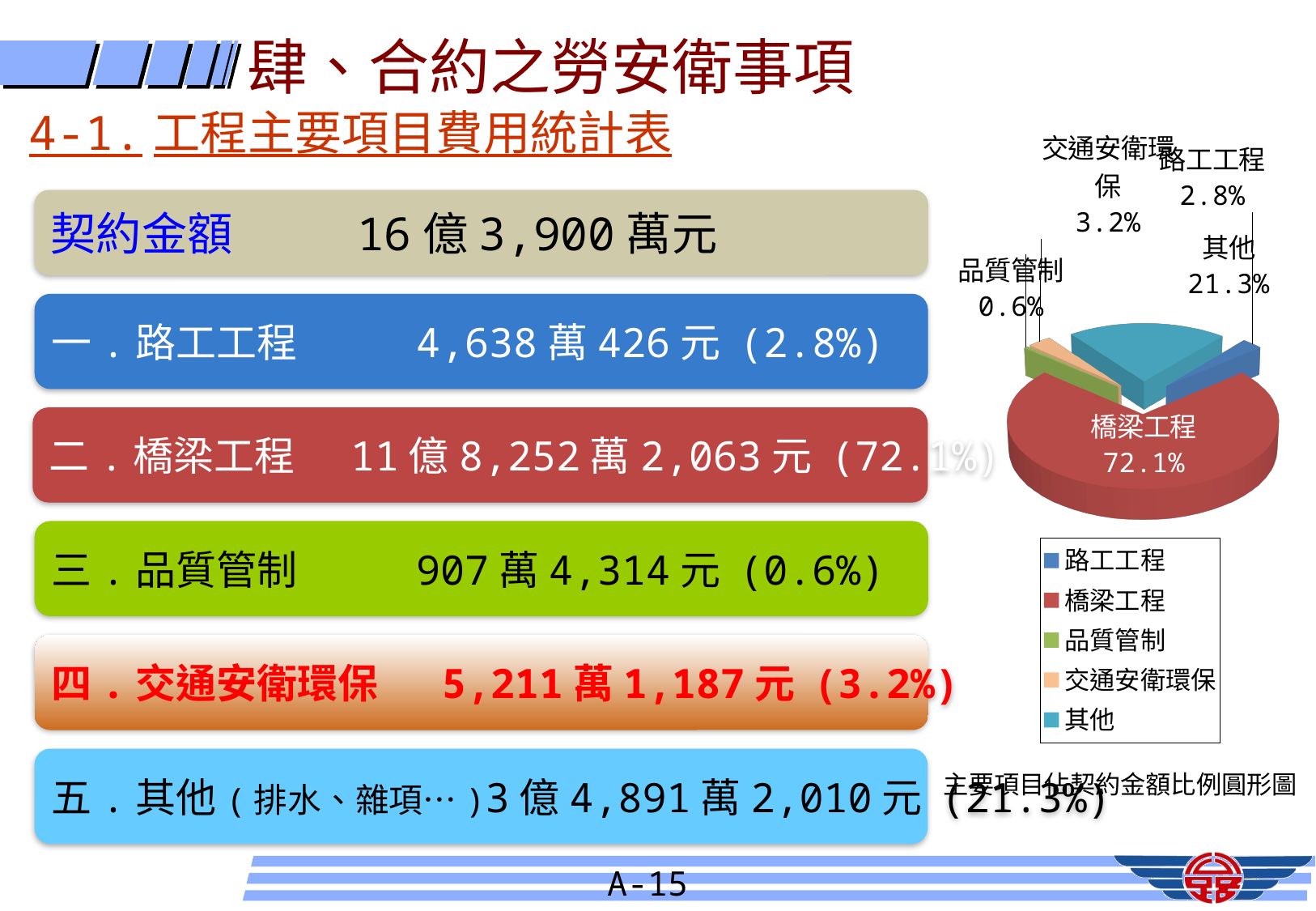
How many categories does the pie chart legend list? 5 In the pie chart, what share does 交通安衛環保 have? 3.2% Which category has the largest slice in the pie chart? 橋梁工程 Which category has the smallest slice in the pie chart? 品質管制 In the pie chart, what share does 其他 have? 21.3% In the pie chart, what share does 品質管制 have? 0.6% In the pie chart, which is larger: 交通安衛環保 or 路工工程? 交通安衛環保 What is the difference in percentage points between the 橋梁工程 and 其他 slices in the pie chart? 50.8 In the pie chart, what share does 橋梁工程 have? 72.1% What colour is the 橋梁工程 slice in the pie chart? red In the pie chart, what share does 路工工程 have? 2.8% What type of chart is shown on the right side of the slide? pie chart